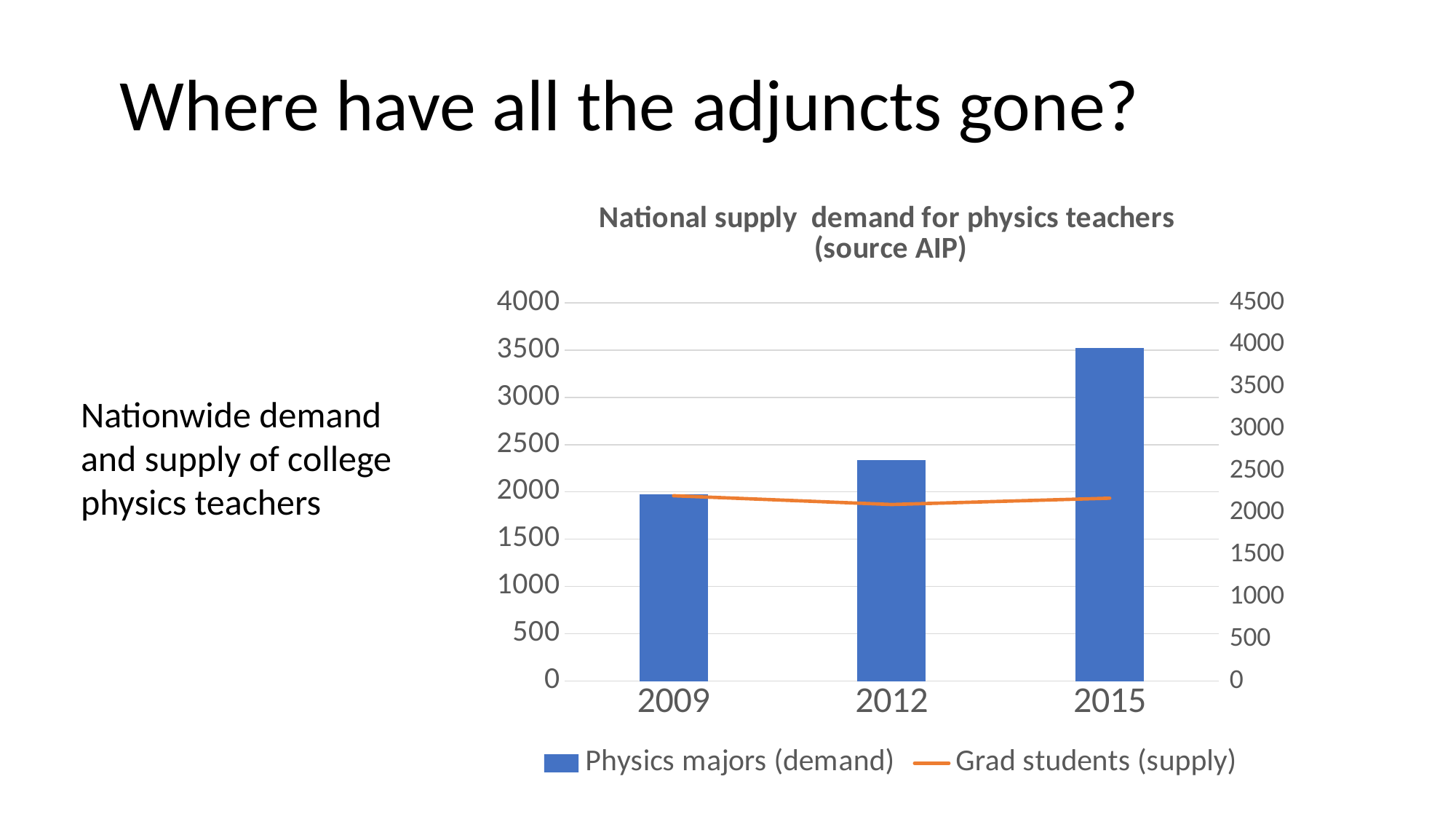
Do the Physics majors (demand) bars rise or fall from 2009 to 2015? Rise Which year has the highest value for Physics majors (demand)? 2015 How many series does the legend list? 2 Is the Grad students (supply) value for 2012 greater or less than 2500 on the right axis? less Is the Physics majors (demand) value for 2015 greater or less than 3000? greater How many years are shown on the x axis? 3 Is the Physics majors (demand) value for 2012 greater or less than 2000? greater Which year has the lowest value for Physics majors (demand)? 2009 Which is larger, the Physics majors (demand) value for 2012 or for 2015? 2015 Which series is drawn as an orange line? Grad students (supply) What kind of chart is shown on the slide? A bar chart combined with a line